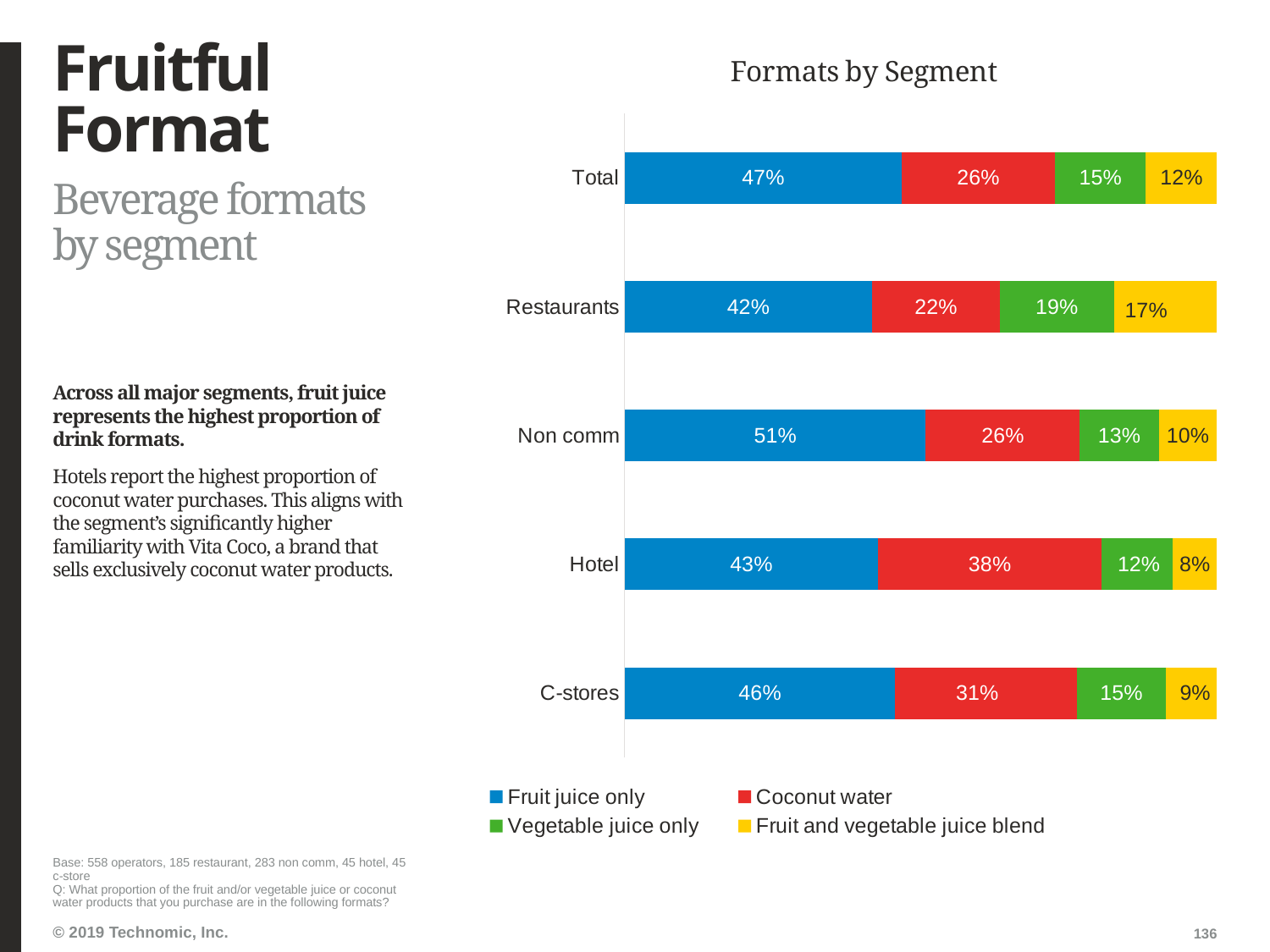
What is the Fruit juice only value for Non comm? 51% How many series does the legend list? 4 What is the title of the chart? Formats by Segment Which segment has the lowest Fruit and vegetable juice blend value? Hotel Which is larger: the Coconut water value for C-stores or for Total? C-stores What is the difference between the Fruit juice only values for Non comm and Restaurants? 9% What is the Fruit and vegetable juice blend value for Restaurants? 17% Which segment has the highest Coconut water value? Hotel What is the Vegetable juice only value for C-stores? 15% What is the Coconut water value for Hotel? 38% What kind of chart is shown? Stacked bar chart How many segments are shown on the chart? 5